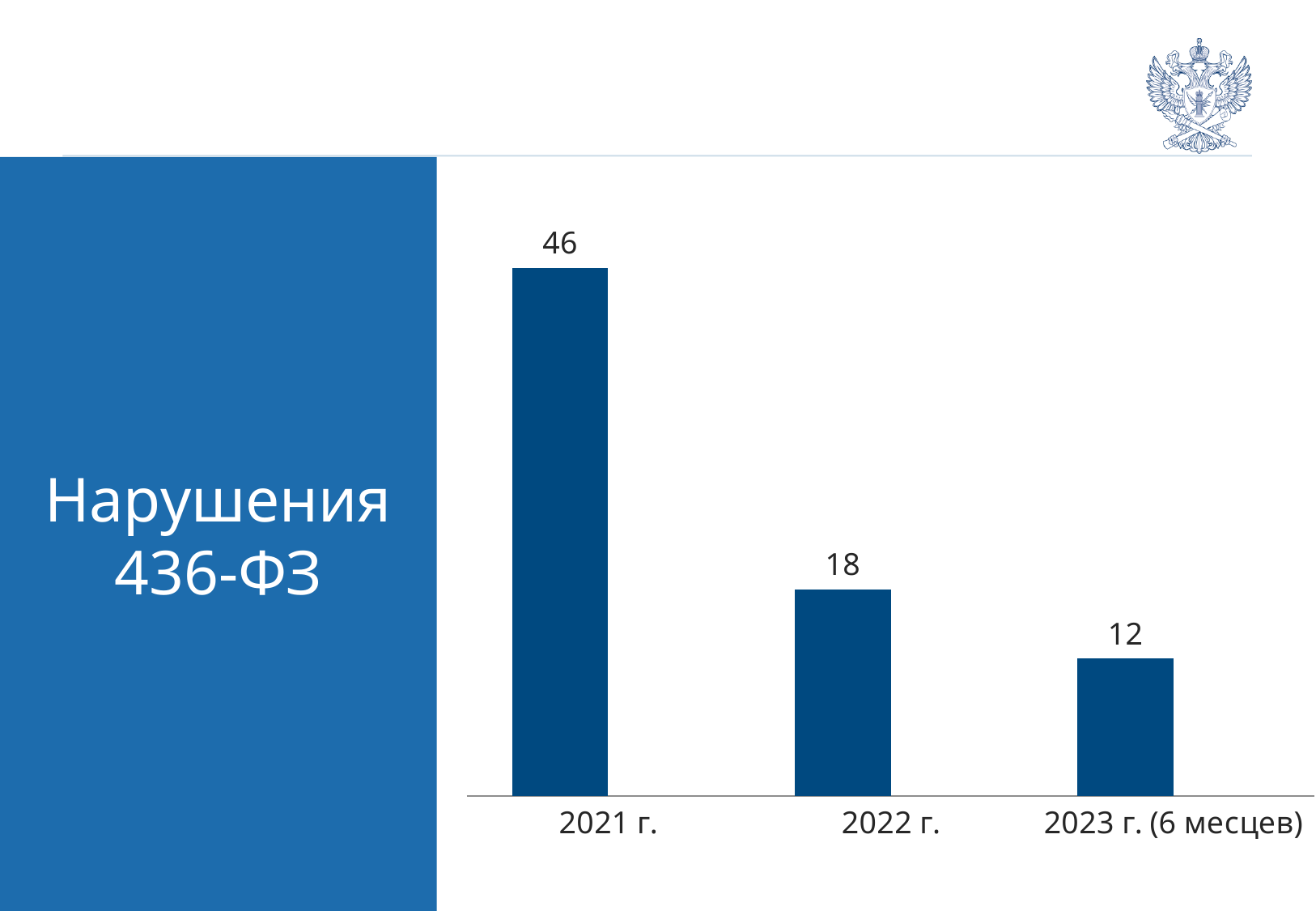
What is the difference between the values for 2022 г. and 2023 г. (6 месцев)? 6 What is the value for 2021 г.? 46 What is the value for 2022 г.? 18 Which category has the highest value? 2021 г. Which is larger, the value for 2022 г. or the value for 2023 г. (6 месцев)? 2022 г. Which category has the lowest value? 2023 г. (6 месцев) What is the title text shown in the blue panel next to the chart? Нарушения 436-ФЗ What is the value for 2023 г. (6 месцев)? 12 How many categories are shown on the x axis? 3 What kind of chart is shown on the slide? bar chart Do the values rise or fall from 2021 г. to 2023 г. (6 месцев)? fall What is the difference between the values for 2021 г. and 2022 г.? 28